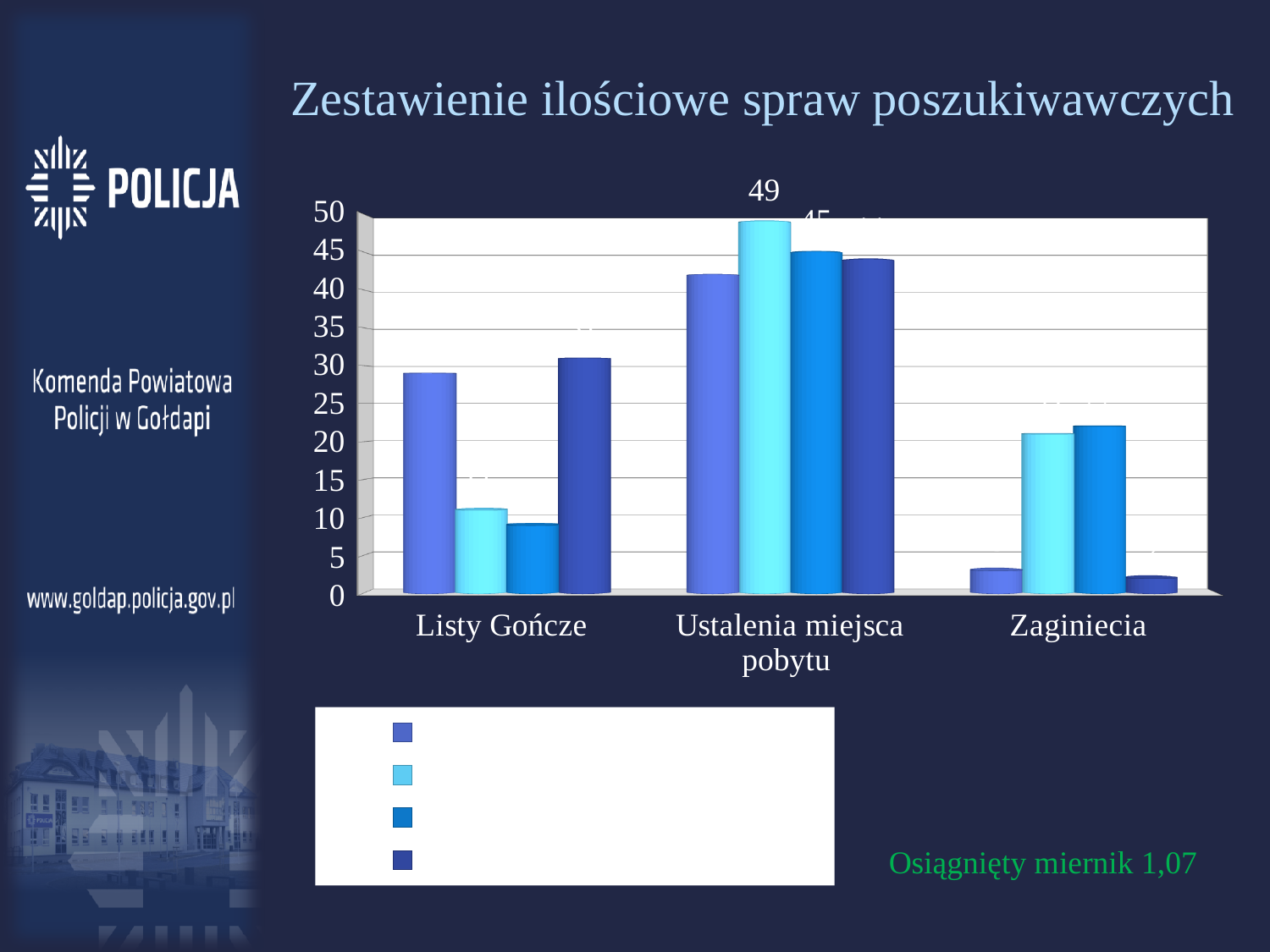
How many categories are shown on the x axis of the chart? 3 Is the value of the light cyan (second) bar for Listy Gończe greater or less than 15? less Which category has the tallest bars in the chart? Ustalenia miejsca pobytu What value of the achieved measure (Osiągnięty miernik) is stated on the slide? 1,07 Is the value of the light cyan (second) bar for Zaginiecia greater or less than 15? greater Which is larger: the first (left-most) bar for Listy Gończe or the first (left-most) bar for Zaginiecia? Listy Gończe What is the value printed above the tallest bar in the chart? 49 What is the title of the chart? Zestawienie ilościowe spraw poszukiwawczych How many series does the chart's legend list? 4 Is the value of the dark blue (right-most) bar for Zaginiecia greater or less than 5? less What kind of chart is shown on the slide? bar chart